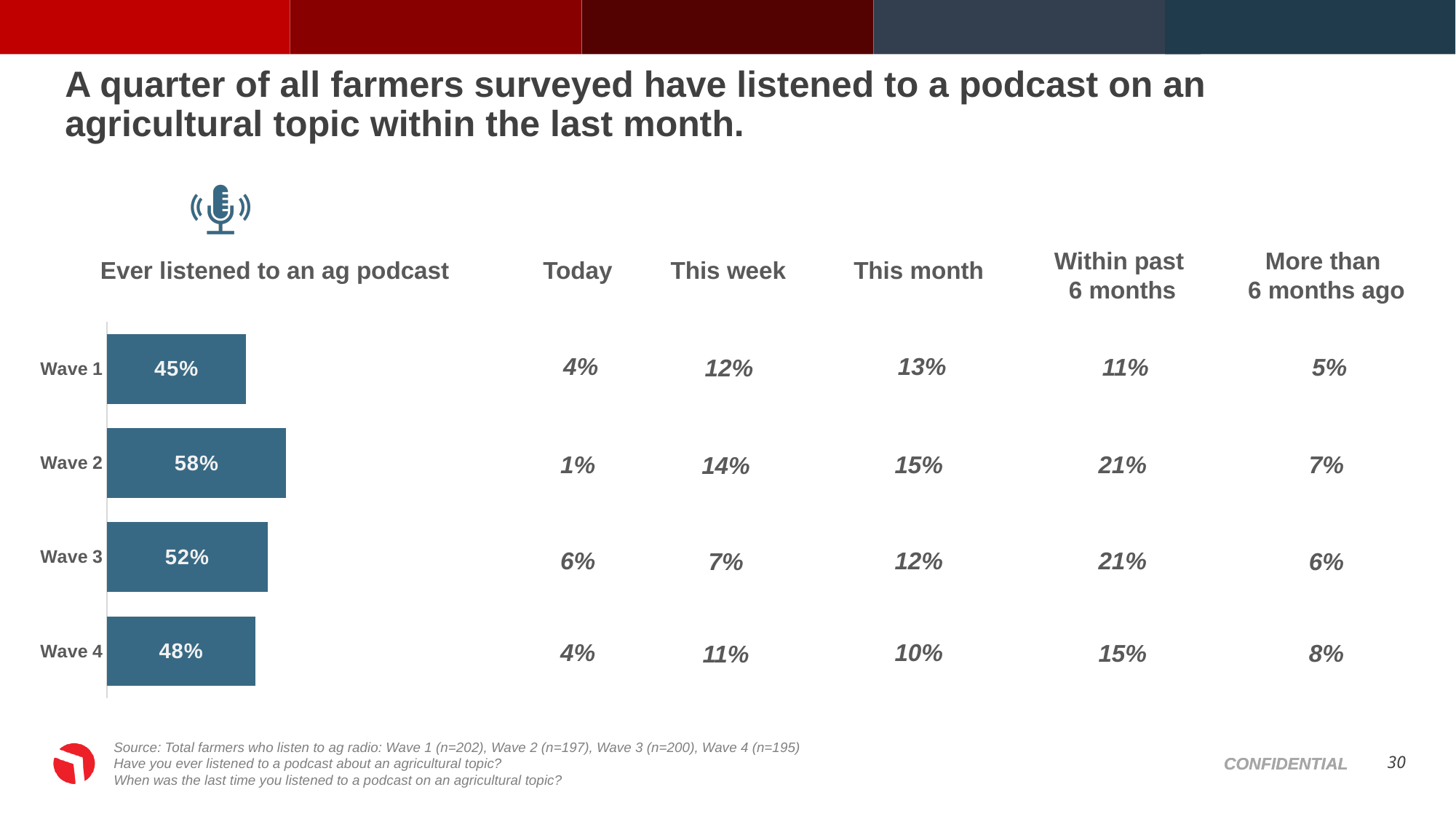
What colour are the bars in the 'Ever listened to an ag podcast' chart? Blue What is the difference in percentage points between Wave 2 and Wave 1 for ever having listened to an ag podcast? 13 What type of chart is used to show 'Ever listened to an ag podcast'? Bar chart Which wave has the lowest share of farmers who have ever listened to an ag podcast? Wave 1 What is the difference in percentage points between Wave 3 and Wave 4 for ever having listened to an ag podcast? 4 What percentage of Wave 2 farmers have ever listened to an ag podcast? 58% Which wave has the highest share of farmers who have ever listened to an ag podcast? Wave 2 What is the title of the bar chart on the slide? Ever listened to an ag podcast What percentage of Wave 4 farmers have ever listened to an ag podcast? 48% How many waves are shown in the 'Ever listened to an ag podcast' bar chart? 4 Which is larger: the share of Wave 3 or Wave 4 farmers who have ever listened to an ag podcast? Wave 3 Does the share of farmers who have ever listened to an ag podcast rise or fall from Wave 2 to Wave 4? Fall